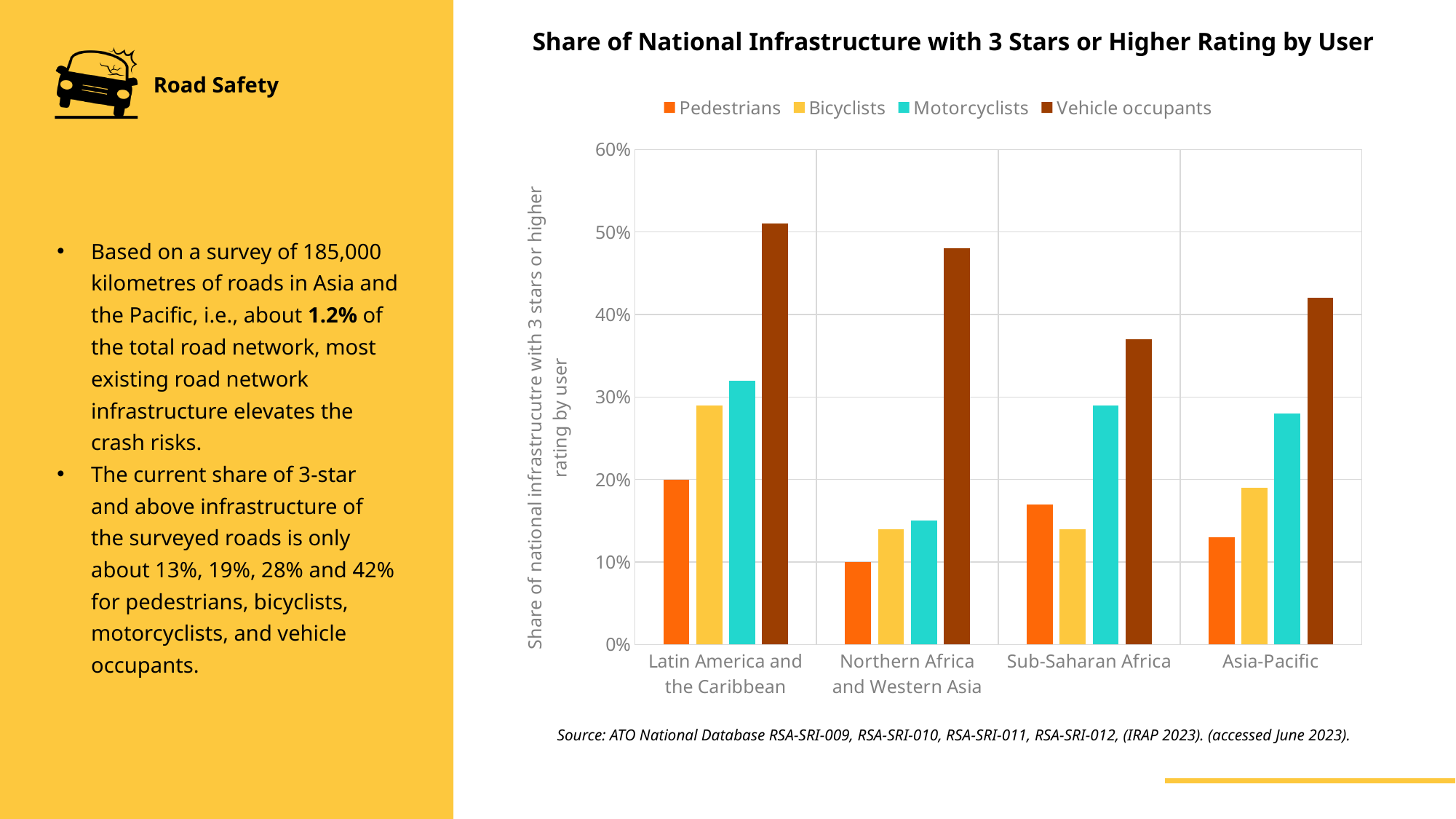
How many series does the legend list? 4 What is the value for Pedestrians in Latin America and the Caribbean? 20% Is the value for Bicyclists in Sub-Saharan Africa greater or less than 20%? less Which region has the lowest value for Motorcyclists? Northern Africa and Western Asia Which series is shown in dark brown in the legend? Vehicle occupants Which region has the highest value for Vehicle occupants? Latin America and the Caribbean What kind of chart is shown on the slide? bar chart Which user group has the highest value in Sub-Saharan Africa? Vehicle occupants Is the value for Vehicle occupants in Asia-Pacific greater or less than 40%? greater How many regions are shown on the x axis? 4 What is the value for Pedestrians in Northern Africa and Western Asia? 10% Which is larger: Motorcyclists in Latin America and the Caribbean or Motorcyclists in Asia-Pacific? Latin America and the Caribbean